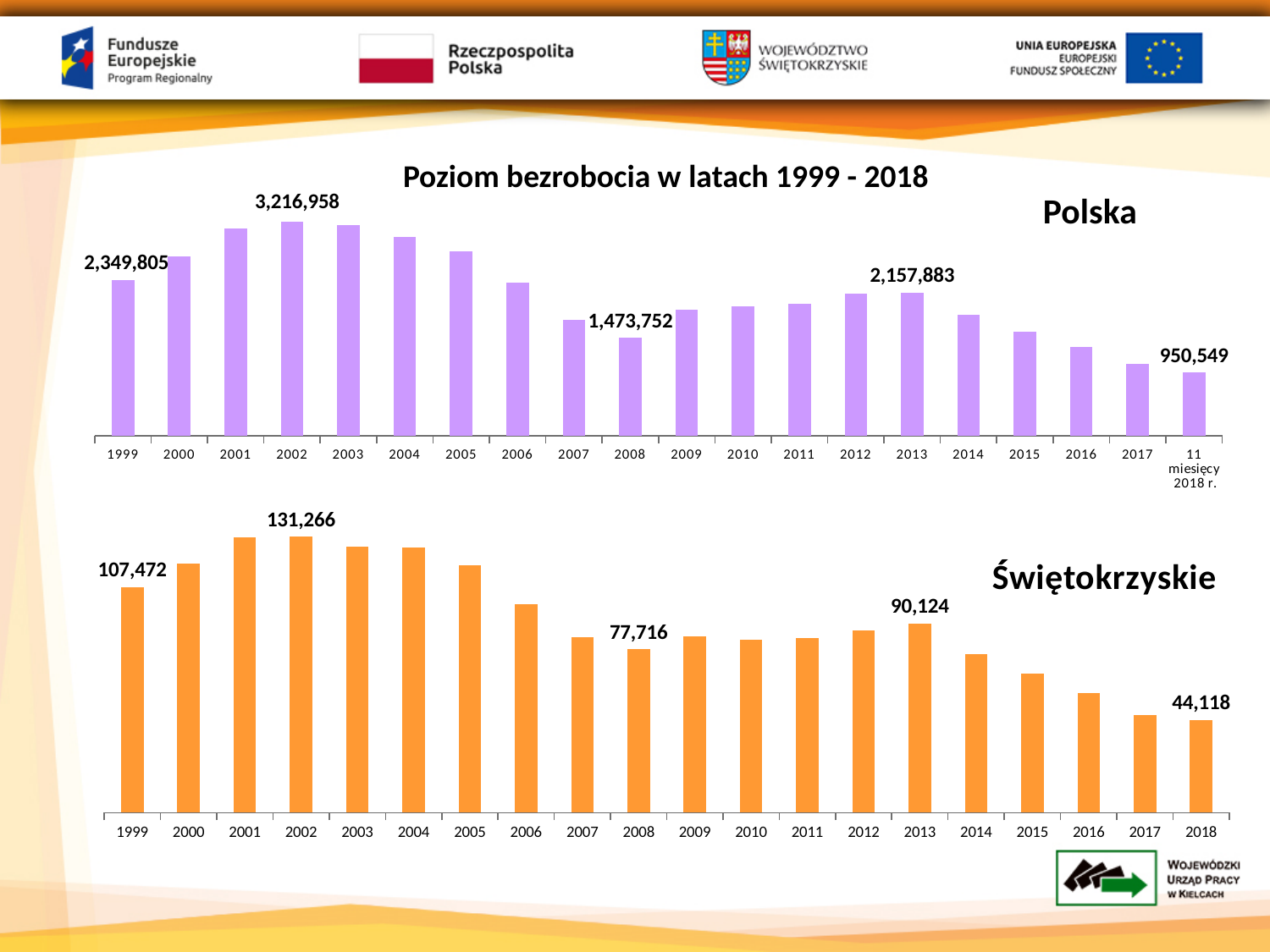
In the Polska chart, what is the difference between the 2002 value and the value for 11 miesięcy 2018 r.? 2,266,409 In the Świętokrzyskie chart, what is the value for 1999? 107,472 In the Polska chart, which year has the highest value? 2002 In the Polska chart, what is the value for 2002? 3,216,958 What kind of chart is the Polska chart? bar chart In the Świętokrzyskie chart, do the values rise or fall from 2013 to 2018? fall How many categories are shown on the x axis of the Świętokrzyskie chart? 20 In the Świętokrzyskie chart, which category has the lowest value? 2018 In the Świętokrzyskie chart, what is the value for 2018? 44,118 In the Polska chart, which is larger, the value for 2013 or the value for 2008? 2013 In the Świętokrzyskie chart, what is the difference between the 2002 value and the 2018 value? 87,148 In the Polska chart, what is the value for 2008? 1,473,752